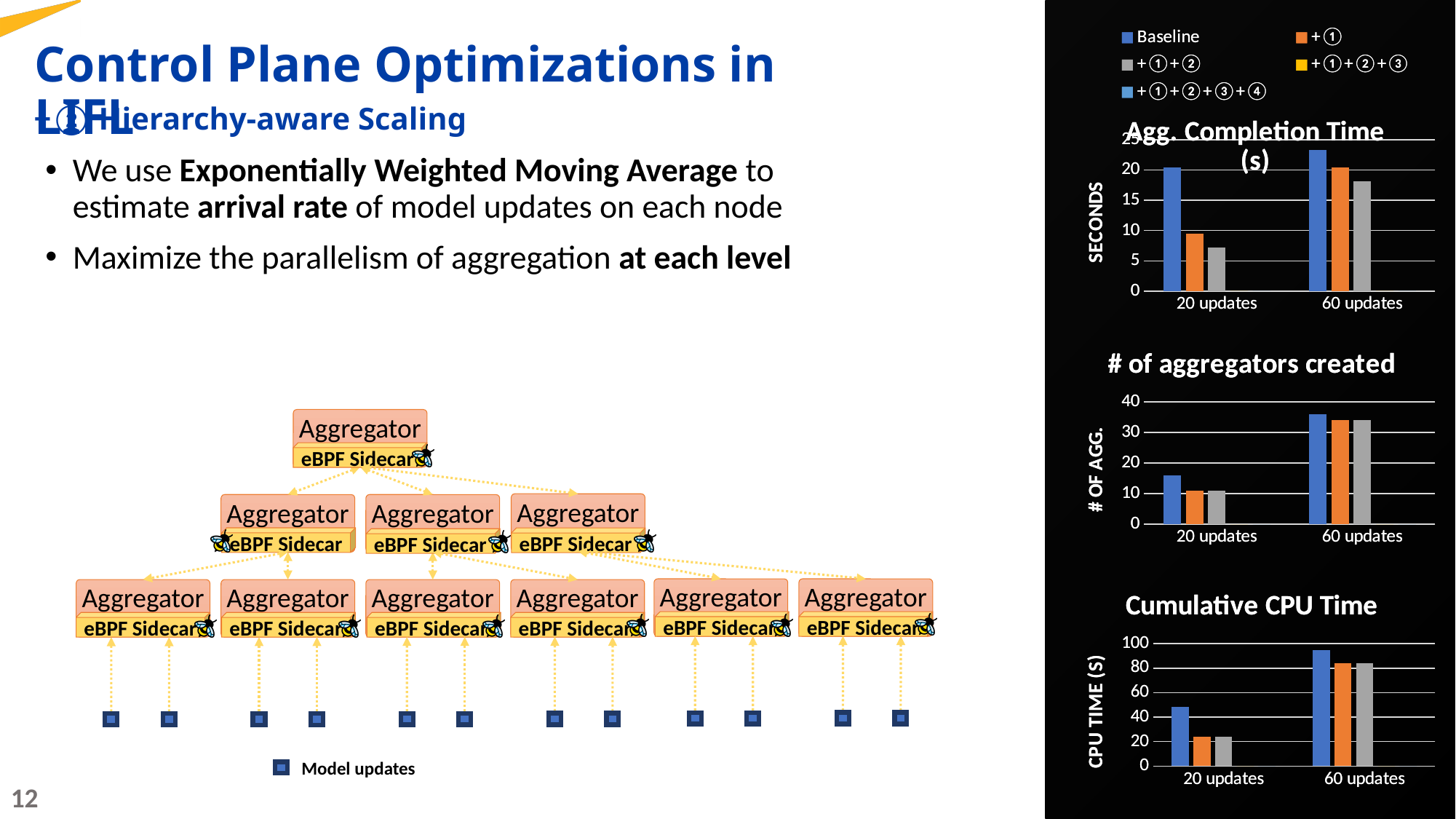
What is the y-axis label of the "Cumulative CPU Time" chart? CPU TIME (S) In the "Agg. Completion Time (s)" chart, is the Baseline value for 20 updates greater or less than 15? greater How many categories are shown on the x axis of the "# of aggregators created" chart? 2 In the "Cumulative CPU Time" chart, is the Baseline value for 60 updates greater or less than 80? greater What kind of chart is the "Agg. Completion Time (s)" chart? bar chart In the "Cumulative CPU Time" chart, is the +① value for 20 updates greater or less than 40? less In the "Agg. Completion Time (s)" chart, is the Baseline value larger for 20 updates or for 60 updates? 60 updates In the "Agg. Completion Time (s)" chart, which series has the highest value for 20 updates? Baseline How many series does the legend at the top of the right panel list? 5